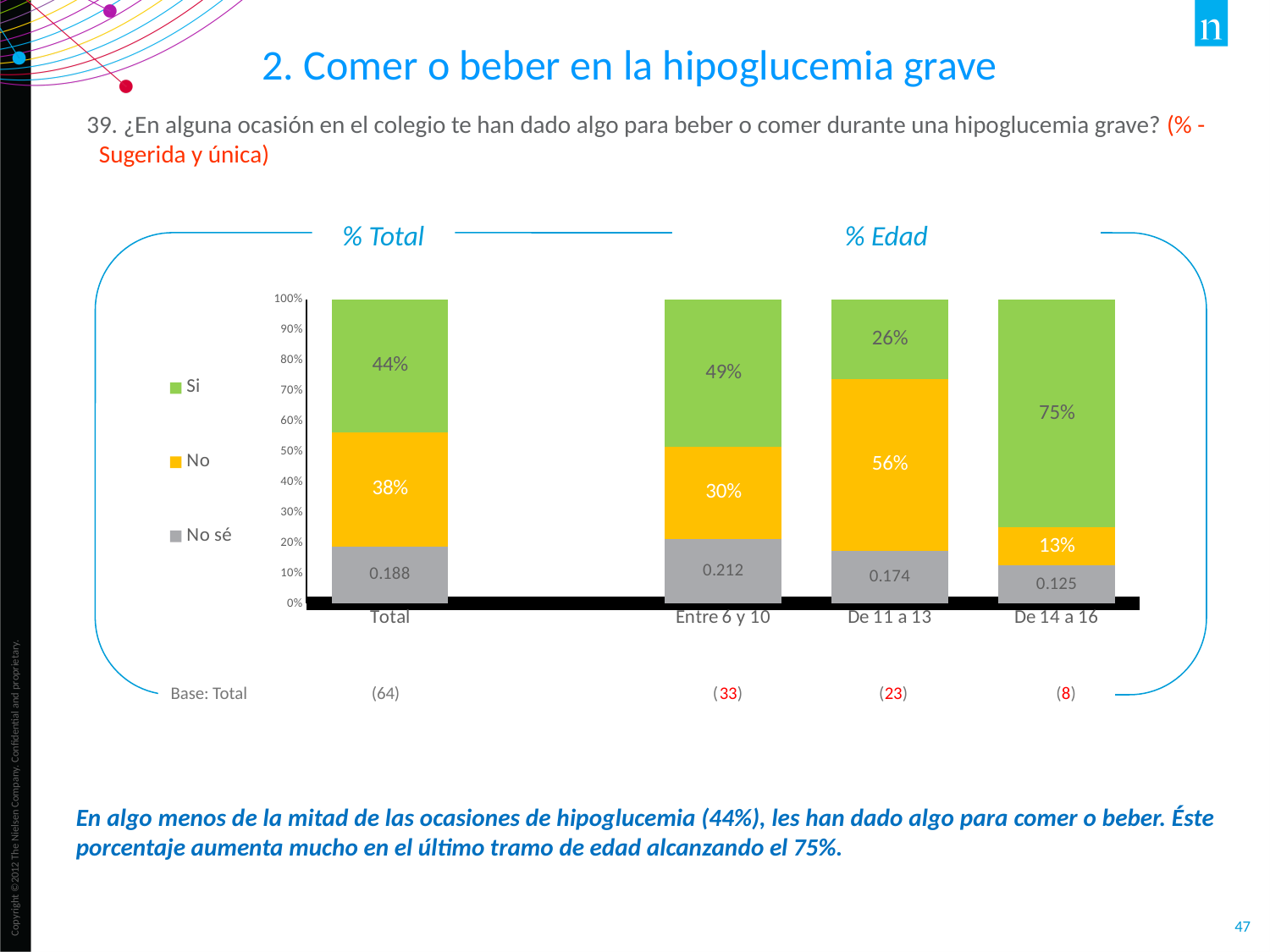
Which category has the lowest 'No' value? De 14 a 16 What kind of chart is shown on the slide? stacked bar chart Which is larger: the 'No' value for 'Entre 6 y 10' or the 'No' value for Total? Total What is the value of 'Si' for the 'De 14 a 16' category? 75% What is the value of 'No sé' for the 'Entre 6 y 10' category, as printed on the slide? 0.212 Which category has the highest 'Si' value? De 14 a 16 How many categories are shown along the x axis? 4 How many series does the legend list? 3 What is the value of 'No' for the 'De 11 a 13' category? 56% What is the value of 'Si' for the Total category? 44% Which legend entry is shown in green? Si What is the difference between the 'Si' values for 'De 14 a 16' and 'De 11 a 13'? 49%